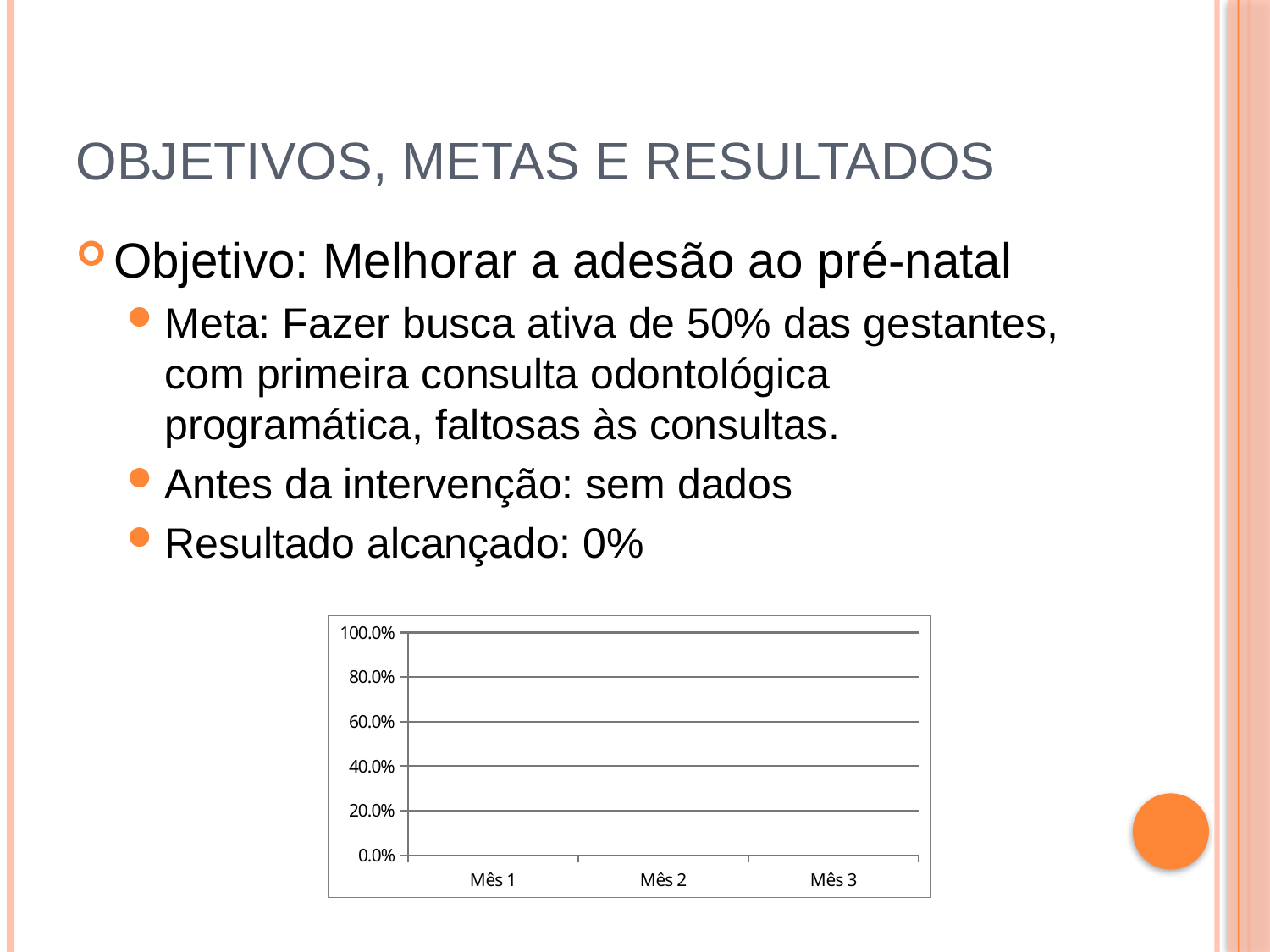
What is the lowest value shown on the chart's y axis? 0.0% Is the value for Mês 1 greater or less than 20%? less What is the label of the first category on the chart's x axis? Mês 1 What is the label of the last category on the chart's x axis? Mês 3 How many categories are shown on the x axis of the chart? 3 Is the value for Mês 2 greater or less than 20%? less Is the value for Mês 3 greater or less than 40%? less What is the highest value shown on the chart's y axis? 100.0% Does the chart show any bar reaching above 0.0% for any month? No